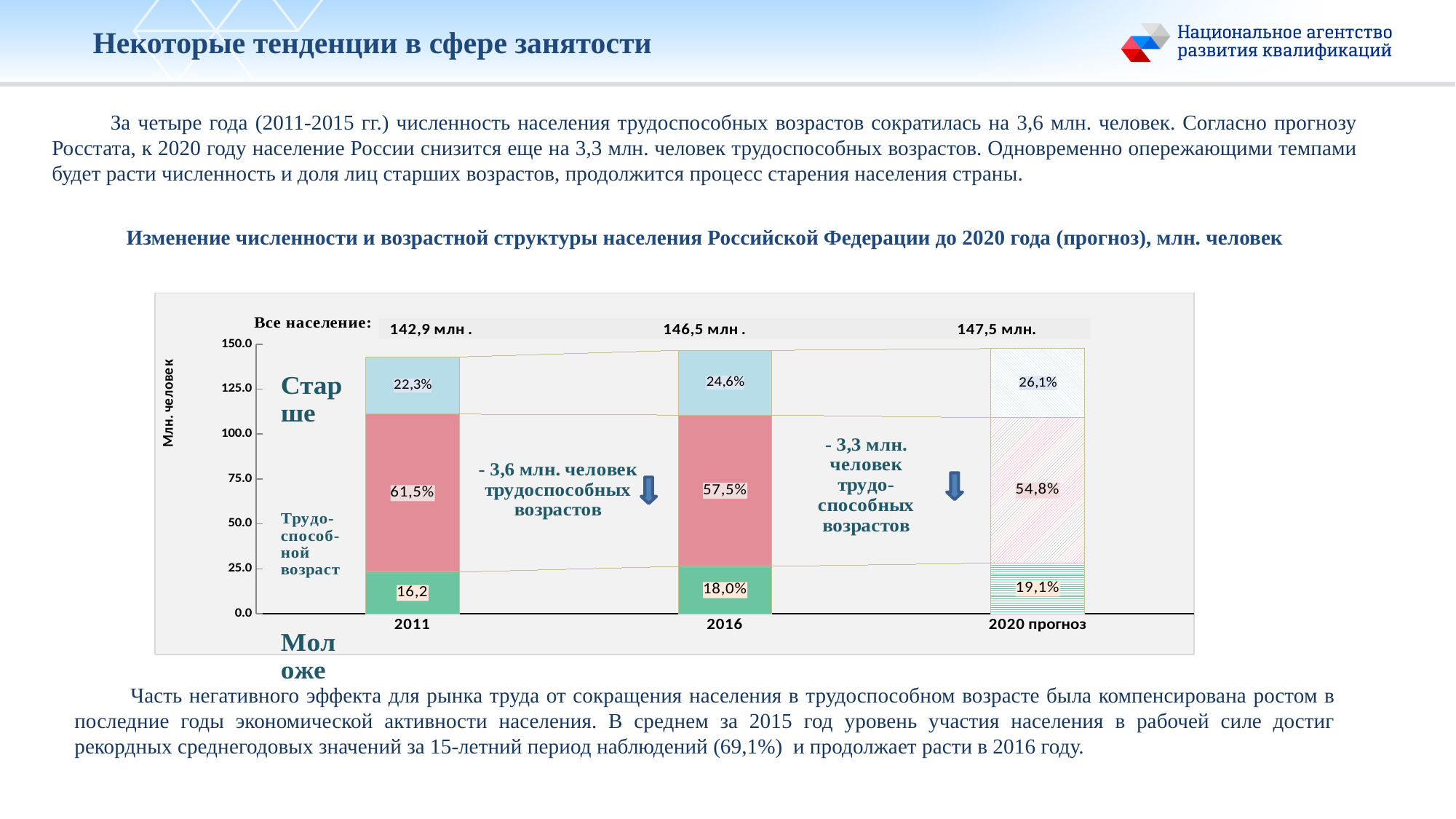
What is the share of the working-age population (Трудоспособный возраст) in the 2020 прогноз bar? 54,8% How many year categories are shown on the x axis of the chart? 3 In which year is the share of the working-age population (Трудоспособный возраст) the highest? 2011 In which year is the share of the older population (Старше) the lowest? 2011 How does the share of the older population (Старше) change from 2011 to 2020 прогноз? rises What is the share of the older population (Старше) in 2016? 24,6% What kind of chart is shown on the slide? stacked bar chart What is the share of the working-age population (Трудоспособный возраст) in 2011? 61,5% By how many percentage points does the working-age share fall from 2011 to 2016? 4,0 What is the share of the younger population (Моложе) in the 2020 прогноз bar? 19,1% What total population (Все население) is shown for 2016? 146,5 млн. Which is larger: the share of the older population (Старше) in 2016 or in 2020 прогноз? 2020 прогноз